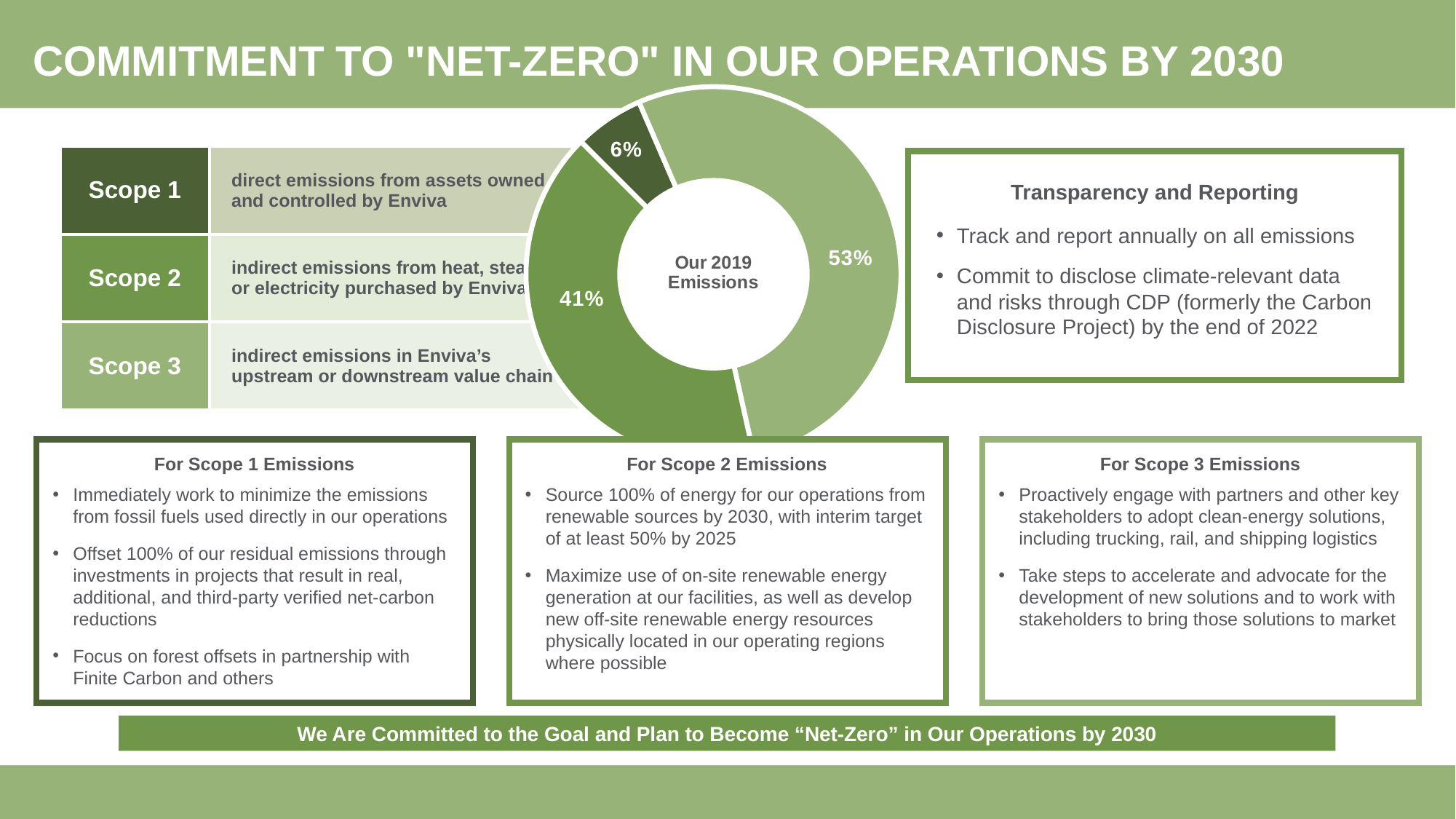
What kind of chart is shown in the centre of the slide? pie chart (donut) In the 'Our 2019 Emissions' chart, what is the difference between the 41% slice and the 6% slice? 35 percentage points How many slices does the 'Our 2019 Emissions' chart have? 3 What share is labelled on the darkest green slice of the 'Our 2019 Emissions' chart? 6% In the 'Our 2019 Emissions' chart, which is larger: the medium green slice or the darkest green slice? the medium green slice (41%) What share is labelled on the medium green slice of the 'Our 2019 Emissions' chart? 41% What is the largest share shown in the 'Our 2019 Emissions' chart? 53% What do the three labelled slices of the 'Our 2019 Emissions' chart add up to? 100% What is the title shown in the centre of the donut chart? Our 2019 Emissions What is the smallest share shown in the 'Our 2019 Emissions' chart? 6% Is the largest slice of the 'Our 2019 Emissions' chart greater or less than 50%? greater In the 'Our 2019 Emissions' chart, what is the difference between the 53% slice and the 41% slice? 12 percentage points